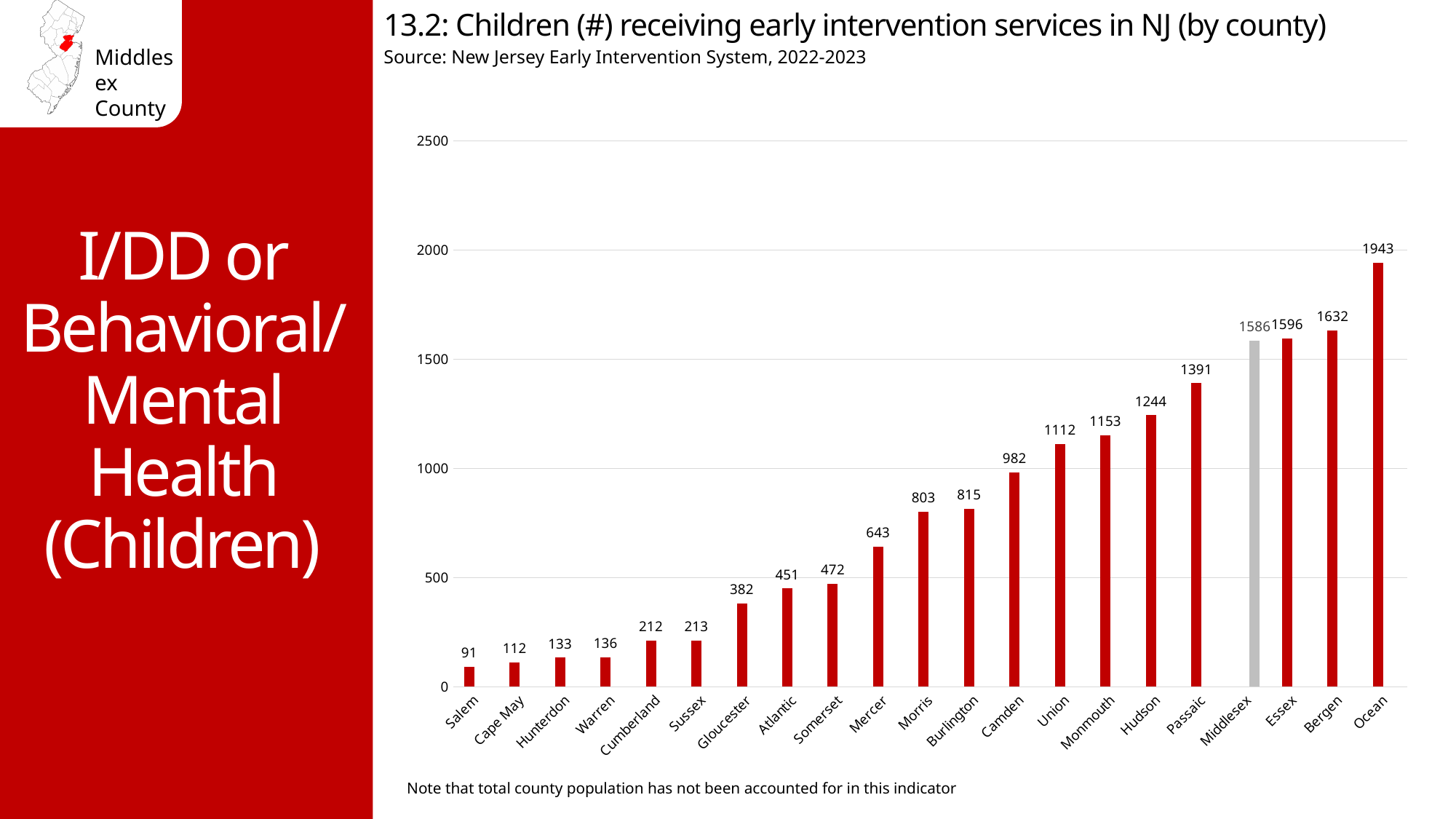
Which county has the highest number of children receiving early intervention services? Ocean What kind of chart is shown on the slide? Bar chart How many counties are shown on the chart? 21 Which county has the lowest number of children receiving early intervention services? Salem How many children are receiving early intervention services in Middlesex County? 1586 Which county's bar is shown in grey rather than red? Middlesex What is the value shown for Salem County? 91 Is the value for Passaic greater or less than 1500? less What is the difference between the values for Ocean and Middlesex? 357 What is the difference between the values for Bergen and Essex? 36 Which has a higher value, Camden or Union? Union What is the value shown for Ocean County? 1943